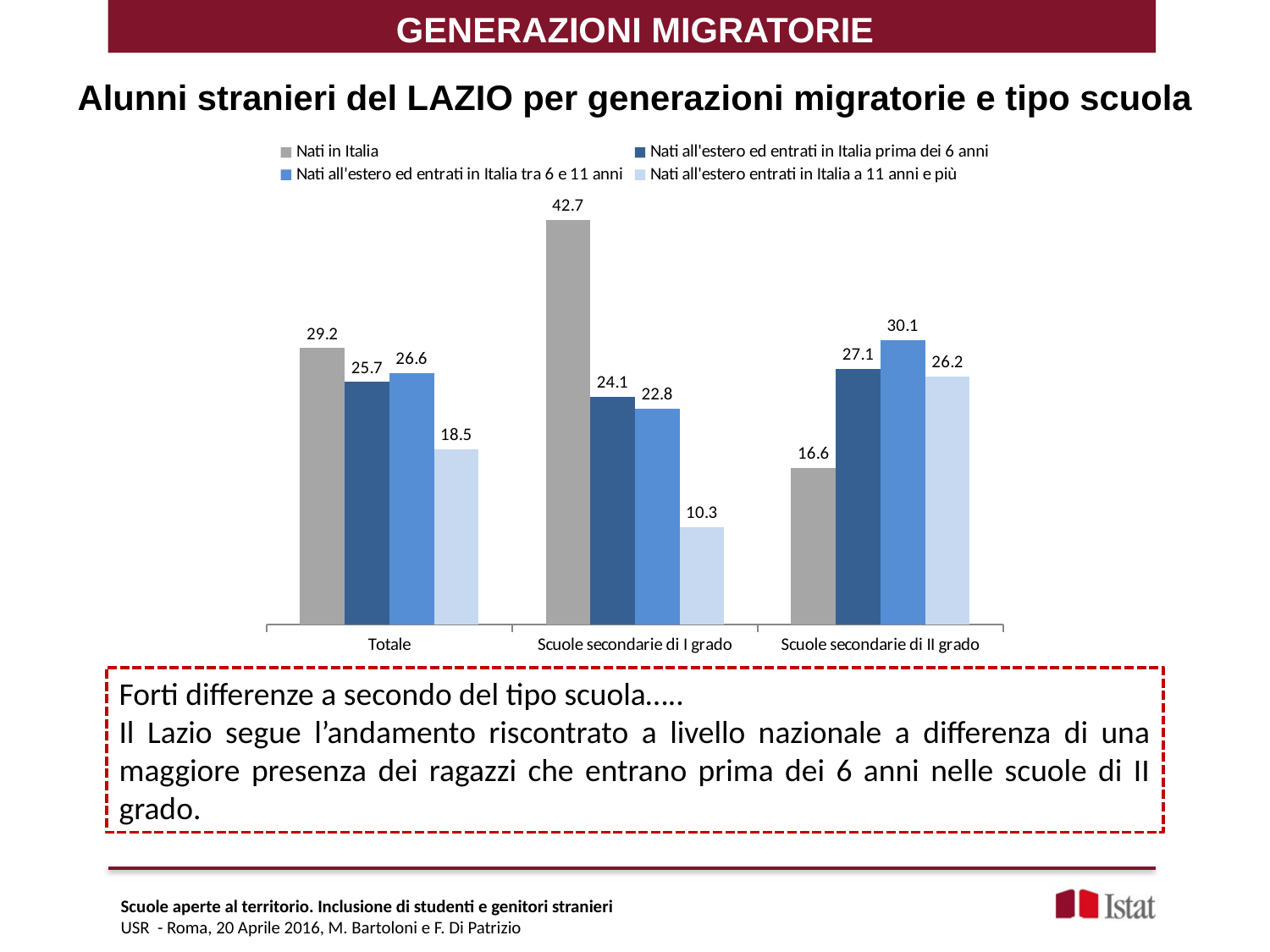
What is the difference between the "Nati in Italia" values for "Scuole secondarie di I grado" and "Scuole secondarie di II grado"? 26.1 Which series has the highest value in the "Scuole secondarie di II grado" category? Nati all'estero ed entrati in Italia tra 6 e 11 anni How many series does the legend list? 4 How do the "Nati in Italia" values change from "Scuole secondarie di I grado" to "Scuole secondarie di II grado"? They fall Which is larger: the "Nati all'estero ed entrati in Italia prima dei 6 anni" value for "Totale" or for "Scuole secondarie di II grado"? Scuole secondarie di II grado What colour are the bars for the "Nati in Italia" series? Grey What kind of chart is shown on the slide? Bar chart What is the value for "Nati all'estero ed entrati in Italia tra 6 e 11 anni" in the "Scuole secondarie di II grado" category? 30.1 What is the value for "Nati all'estero entrati in Italia a 11 anni e più" in the "Totale" category? 18.5 What is the value for "Nati in Italia" in the "Scuole secondarie di I grado" category? 42.7 How many categories are shown on the x axis? 3 Which series has the lowest value in the "Scuole secondarie di I grado" category? Nati all'estero entrati in Italia a 11 anni e più